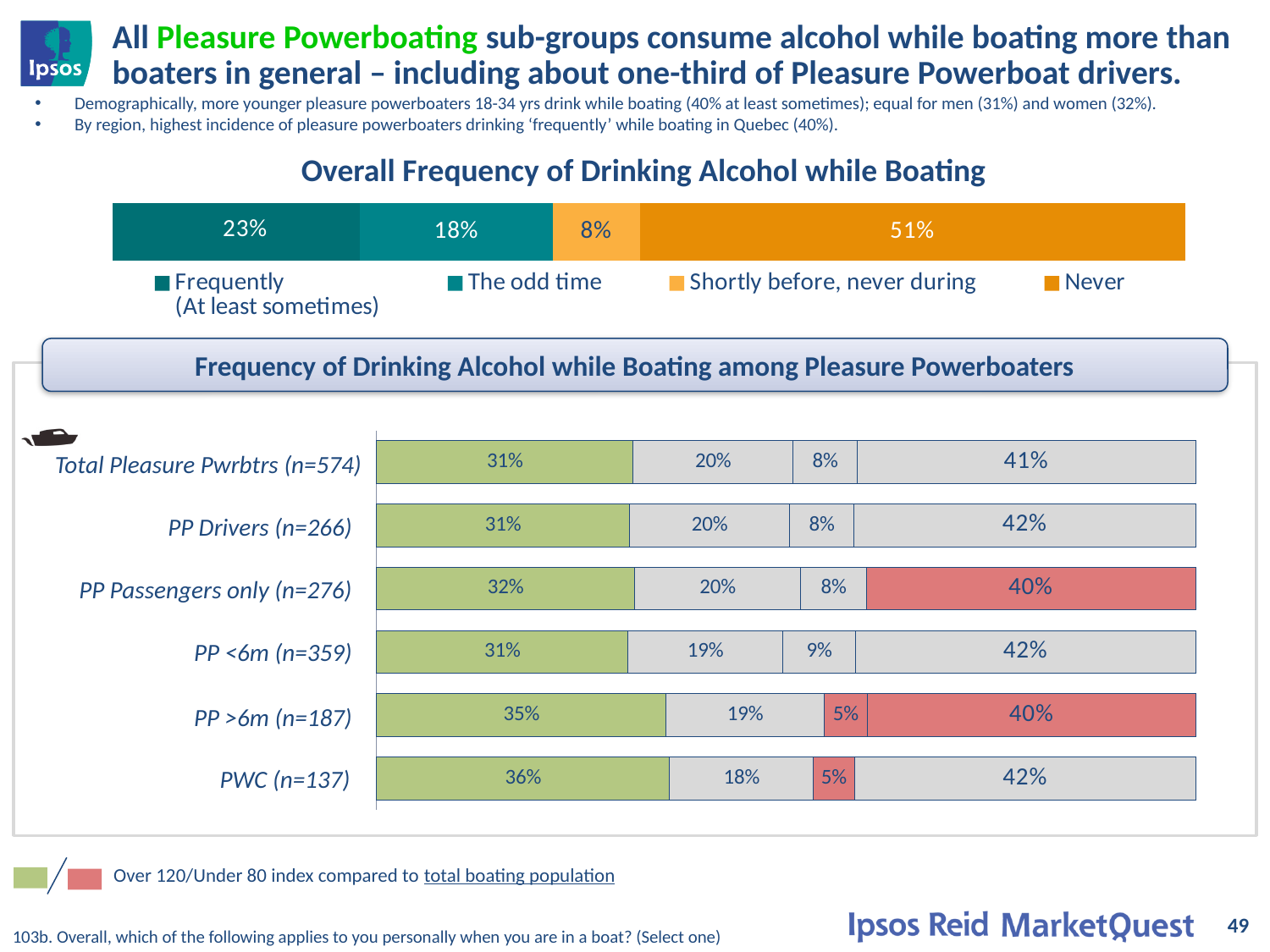
In the 'Frequency of Drinking Alcohol while Boating among Pleasure Powerboaters' chart, how many sub-groups (bars) are shown? 6 In the 'Overall Frequency of Drinking Alcohol while Boating' chart, what is the difference between the 'Never' value and the 'Frequently (At least sometimes)' value? 28 percentage points In the 'Overall Frequency of Drinking Alcohol while Boating' chart, what percentage is shown for 'Never'? 51% In the 'Frequency of Drinking Alcohol while Boating among Pleasure Powerboaters' chart, what is the value of the last (rightmost) segment for 'PP Passengers only (n=276)'? 40% In the 'Overall Frequency of Drinking Alcohol while Boating' chart, which category has the smallest share of the bar? Shortly before, never during In the 'Frequency of Drinking Alcohol while Boating among Pleasure Powerboaters' chart, which is larger: the third segment for 'PP <6m (n=359)' or the third segment for 'PP >6m (n=187)'? PP <6m (n=359) What type of chart is 'Frequency of Drinking Alcohol while Boating among Pleasure Powerboaters'? Stacked bar chart In the 'Frequency of Drinking Alcohol while Boating among Pleasure Powerboaters' chart, what is the difference between the first-segment values of 'PP >6m (n=187)' and 'PP <6m (n=359)'? 4 percentage points In the 'Overall Frequency of Drinking Alcohol while Boating' chart, how many categories does the legend list? 4 In the 'Frequency of Drinking Alcohol while Boating among Pleasure Powerboaters' chart, what is the value of the first (leftmost) segment for 'PWC (n=137)'? 36% In the 'Frequency of Drinking Alcohol while Boating among Pleasure Powerboaters' chart, which sub-group has the highest value in the first (leftmost) segment? PWC (n=137) In the 'Overall Frequency of Drinking Alcohol while Boating' chart, what percentage is shown for 'Frequently (At least sometimes)'? 23%